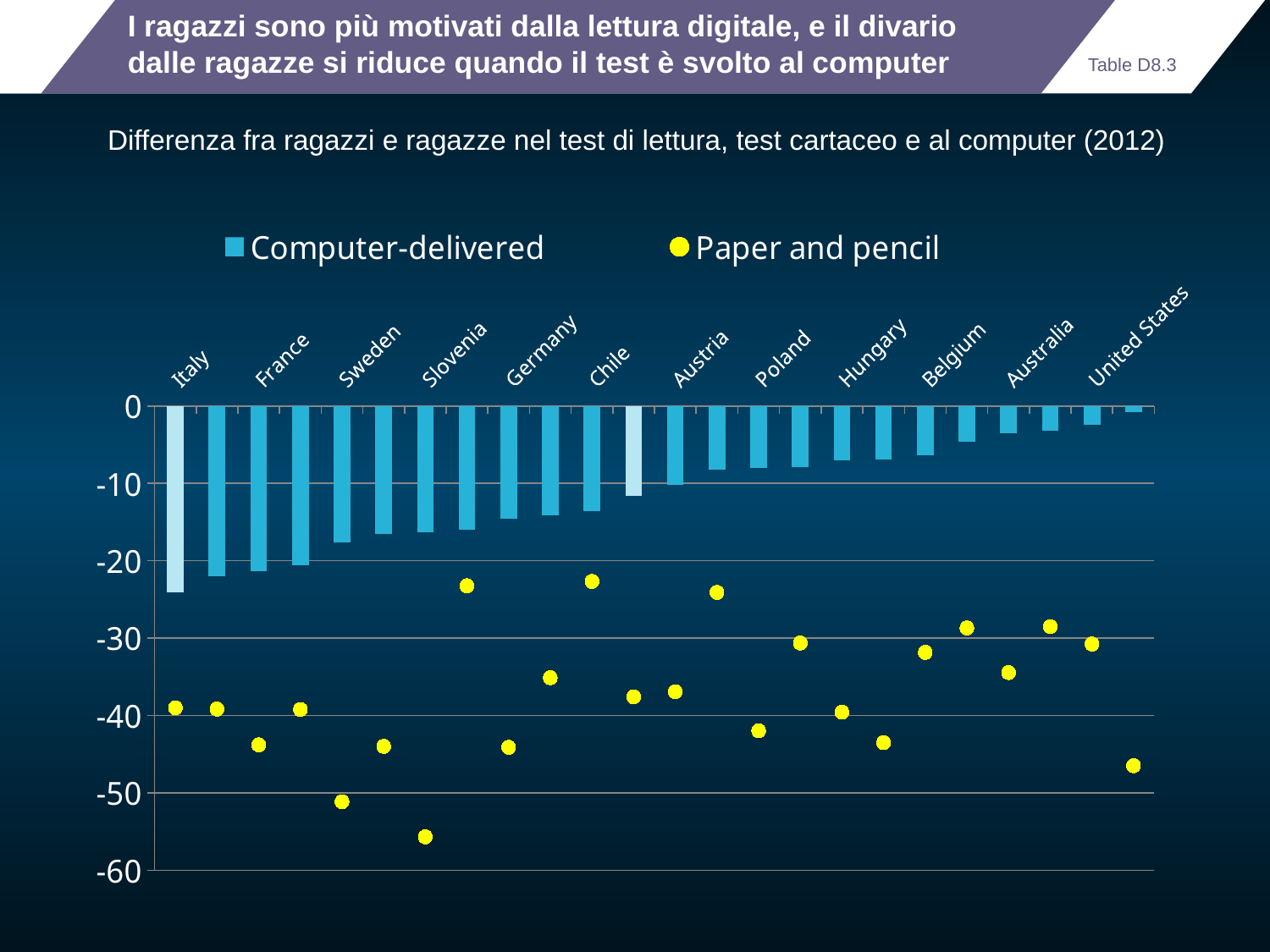
Is the Computer-delivered value for Germany greater or less than -10? less For Italy, which series shows the larger gap between boys and girls: Computer-delivered or Paper and pencil? Paper and pencil What is the lowest value shown on the vertical axis? -60 Is the Paper and pencil value for Italy greater or less than -30? less Is the Computer-delivered value for Poland greater or less than -10? greater How many country labels are shown on the x axis? 12 What kind of chart is used to show the Computer-delivered series? bar chart Which labelled country has the largest (most negative) Computer-delivered gap? Italy How many series does the legend list? 2 Do the Computer-delivered bars get closer to zero or further from zero moving from left to right along the x axis? closer to zero What are the two series named in the legend? Computer-delivered and Paper and pencil